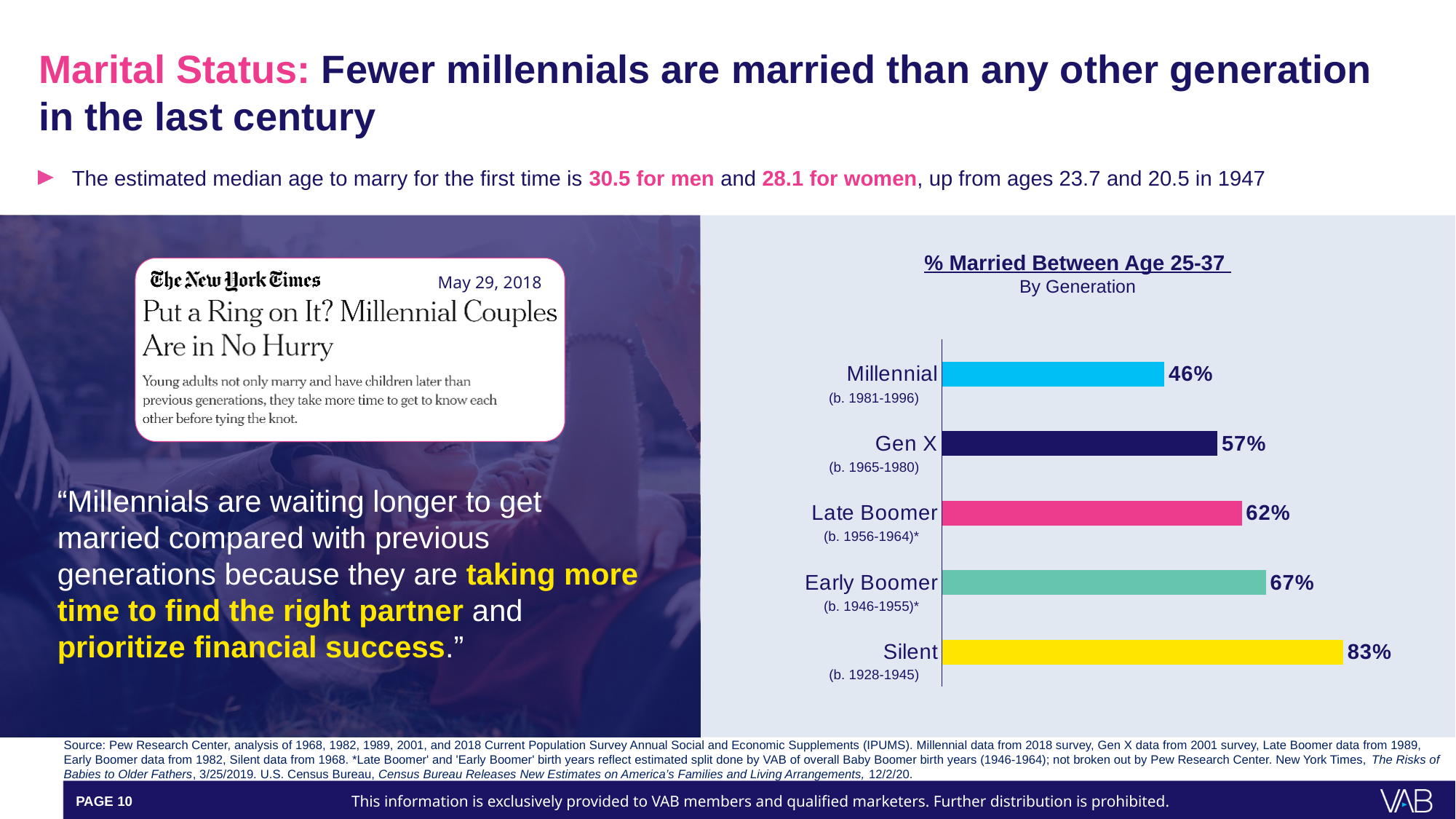
What is the difference between Early Boomer and Late Boomer values? 5 What is the title of the chart? % Married Between Age 25-37 By Generation What is the difference in percentage points between the Silent generation and Millennials? 37 What percentage of Millennials were married between age 25-37? 46% What percentage is shown for Late Boomer? 62% What is the value for the Silent generation? 83% How many generations are shown in the chart? 5 Which has a higher value, Gen X or Early Boomer? Early Boomer What type of chart is used to show % married by generation? Bar chart What is the value shown for Gen X in the chart? 57% Which generation has the highest percentage married between age 25-37? Silent Which generation has the lowest percentage married between age 25-37? Millennial